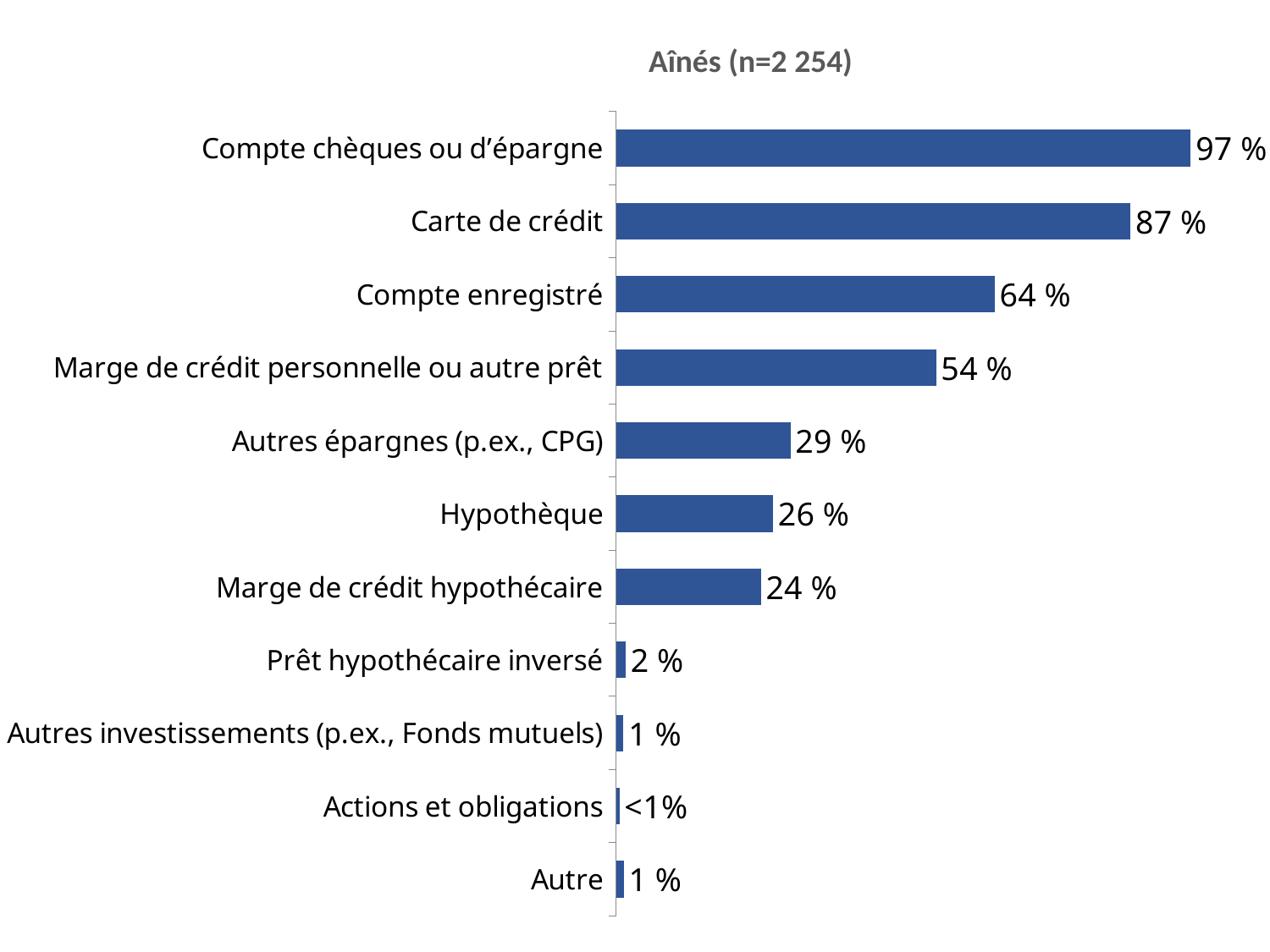
Which is larger, Autres épargnes (p.ex., CPG) or Hypothèque? Autres épargnes (p.ex., CPG) What is the value for Actions et obligations? <1% Which category has the highest value? Compte chèques ou d’épargne What is the difference between Compte chèques ou d’épargne and Carte de crédit? 10 % What is the difference between Compte enregistré and Marge de crédit personnelle ou autre prêt? 10 % What is the value for Hypothèque? 26 % What is the value for Carte de crédit? 87 % What is the title of the chart? Aînés (n=2 254) What kind of chart is this? Bar chart Which category has the lowest value? Actions et obligations What is the value for Marge de crédit personnelle ou autre prêt? 54 % How many categories are shown in the chart? 11